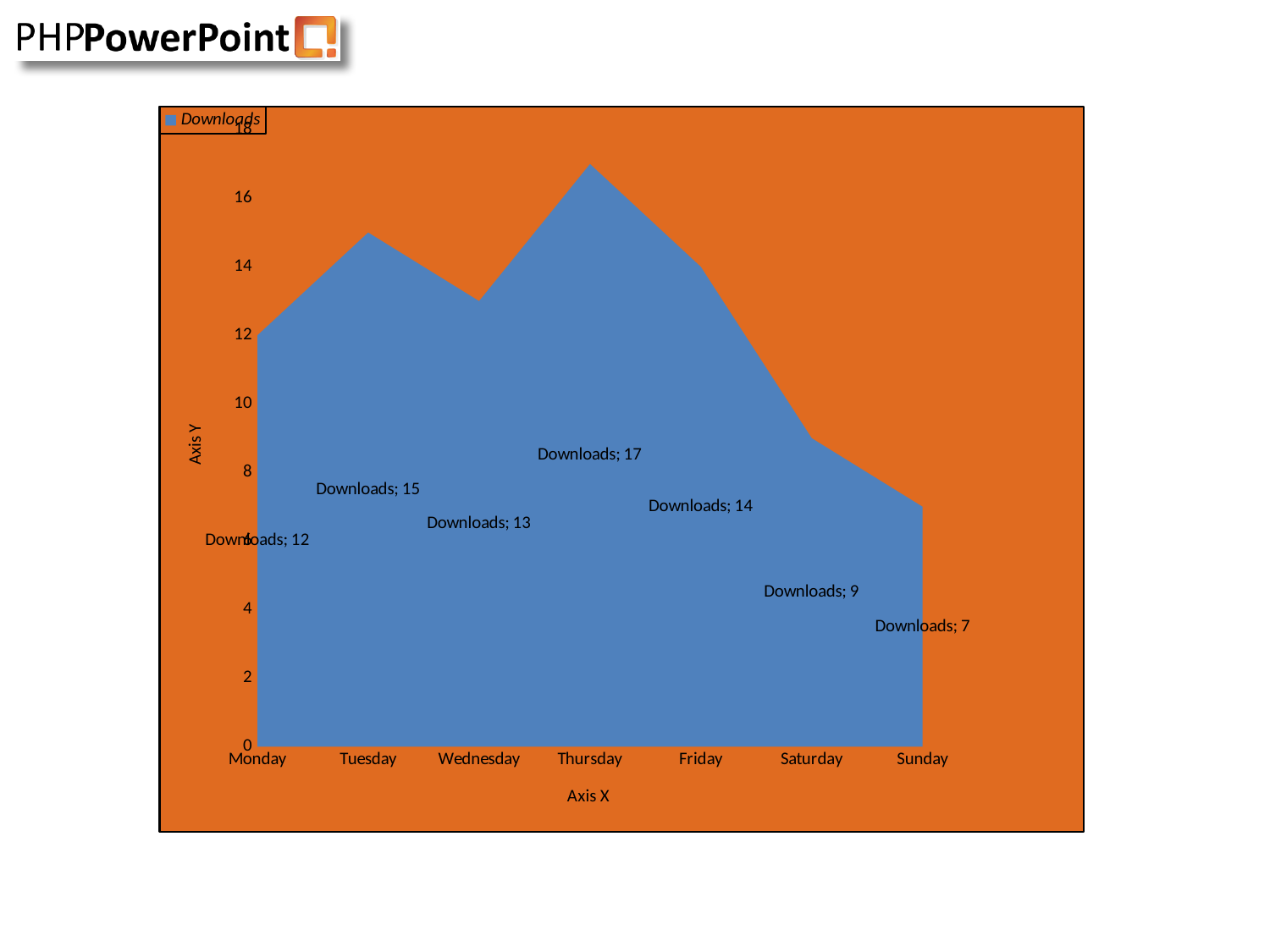
Which has a larger Downloads value, Tuesday or Friday? Tuesday What kind of chart is shown on the slide? area chart Which day has the highest Downloads value? Thursday Which day has the lowest Downloads value? Sunday What is the Downloads value for Sunday? 7 Is the Downloads value for Saturday greater or less than 10? less What is the Downloads value for Thursday? 17 How many series does the legend list? 1 What is the difference between the Downloads values for Thursday and Sunday? 10 What is the Downloads value for Tuesday? 15 How many days are shown on the x axis? 7 What is the title of the vertical axis? Axis Y